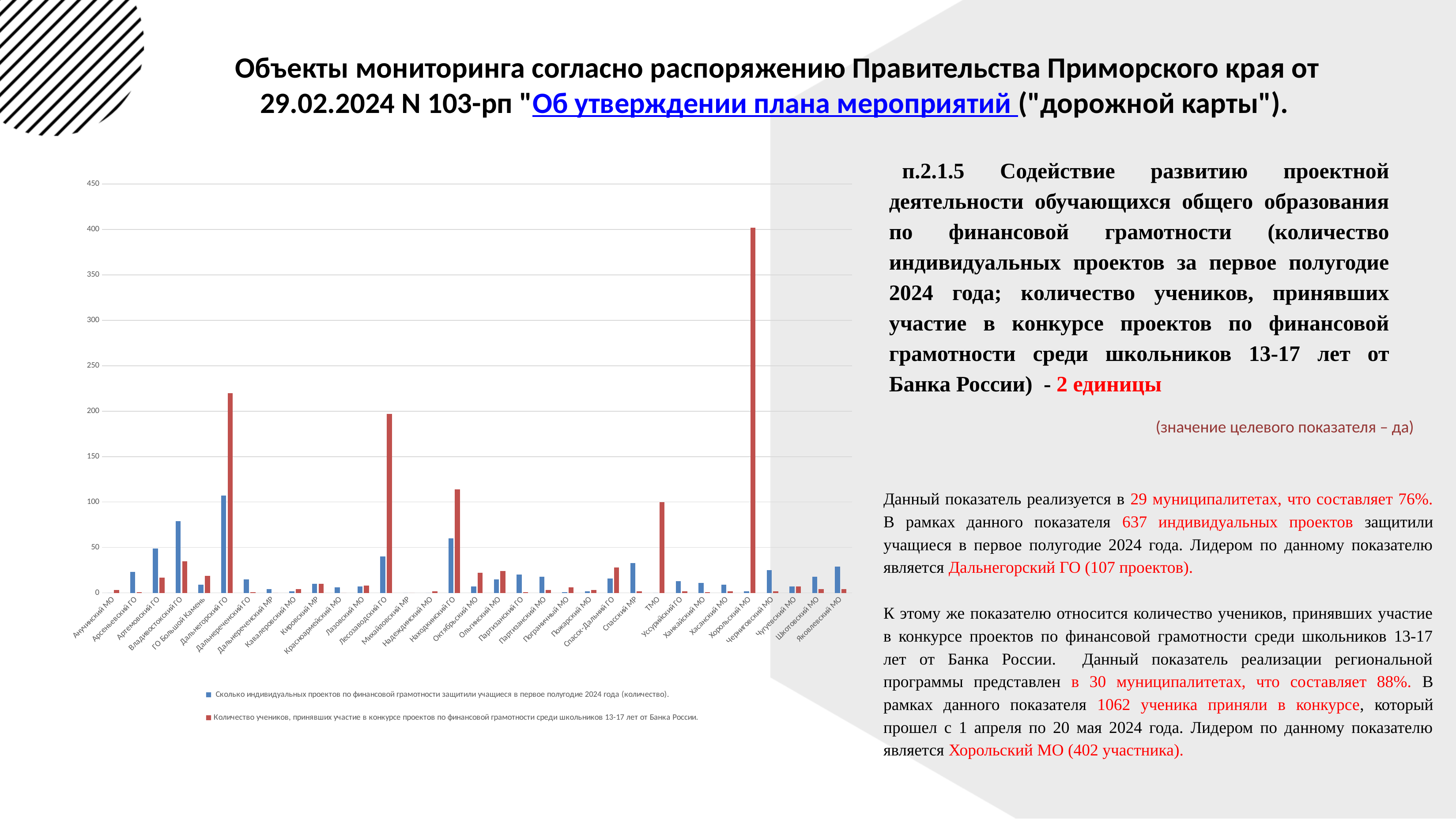
How many municipalities (categories) are shown on the x axis of the chart? 33 Which municipality has the highest number of students who took part in the Bank of Russia project competition (red series)? Хорольский МО How many series does the chart legend list? 2 How many individual projects were defended in Дальнегорский ГО, according to the slide? 107 Which municipality has the highest number of individual financial literacy projects defended (blue series)? Дальнегорский ГО Is the number of competition participants (red bar) for Октябрьский МО greater or less than 100? less Which has more individual projects defended (blue bar): Владивостокский ГО or Артемовский ГО? Владивостокский ГО Which has more competition participants (red bar): Дальнегорский ГО or Лесозаводский ГО? Дальнегорский ГО How many participants from Хорольский МО took part in the competition, according to the slide? 402 Is the number of competition participants (red bar) for Дальнегорский ГО greater or less than 200? greater What kind of chart is shown on the slide? bar chart Is the number of competition participants (red bar) for Хорольский МО greater or less than 400? greater